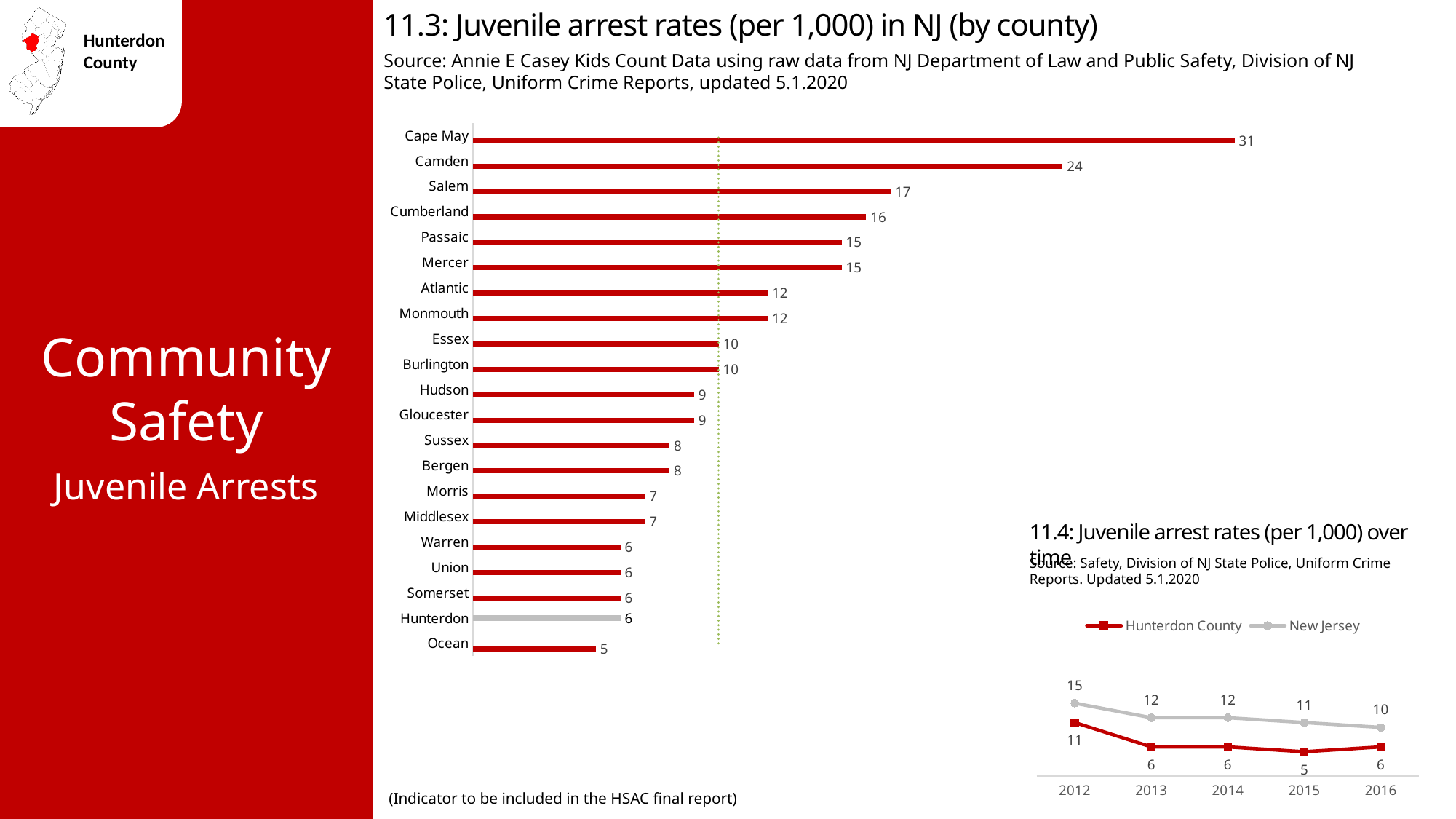
In the chart '11.4: Juvenile arrest rates (per 1,000) over time', what is the value for New Jersey in 2016? 10 In the chart '11.4: Juvenile arrest rates (per 1,000) over time', does the New Jersey series rise or fall from 2012 to 2016? Fall How many series does the legend list in the chart '11.4: Juvenile arrest rates (per 1,000) over time'? 2 In the chart '11.3: Juvenile arrest rates (per 1,000) in NJ (by county)', which county has the highest juvenile arrest rate? Cape May In the chart '11.4: Juvenile arrest rates (per 1,000) over time', what is the value for Hunterdon County in 2012? 11 How many counties are shown in the chart '11.3: Juvenile arrest rates (per 1,000) in NJ (by county)'? 21 In the chart '11.3: Juvenile arrest rates (per 1,000) in NJ (by county)', which has a higher value, Cumberland or Atlantic? Cumberland In the chart '11.3: Juvenile arrest rates (per 1,000) in NJ (by county)', what is the difference between the values for Camden and Salem? 7 What kind of chart is '11.3: Juvenile arrest rates (per 1,000) in NJ (by county)'? Bar chart In the chart '11.3: Juvenile arrest rates (per 1,000) in NJ (by county)', what is the value for Cape May? 31 In the chart '11.3: Juvenile arrest rates (per 1,000) in NJ (by county)', what is the value for Hunterdon? 6 In the chart '11.3: Juvenile arrest rates (per 1,000) in NJ (by county)', which county has the lowest juvenile arrest rate? Ocean